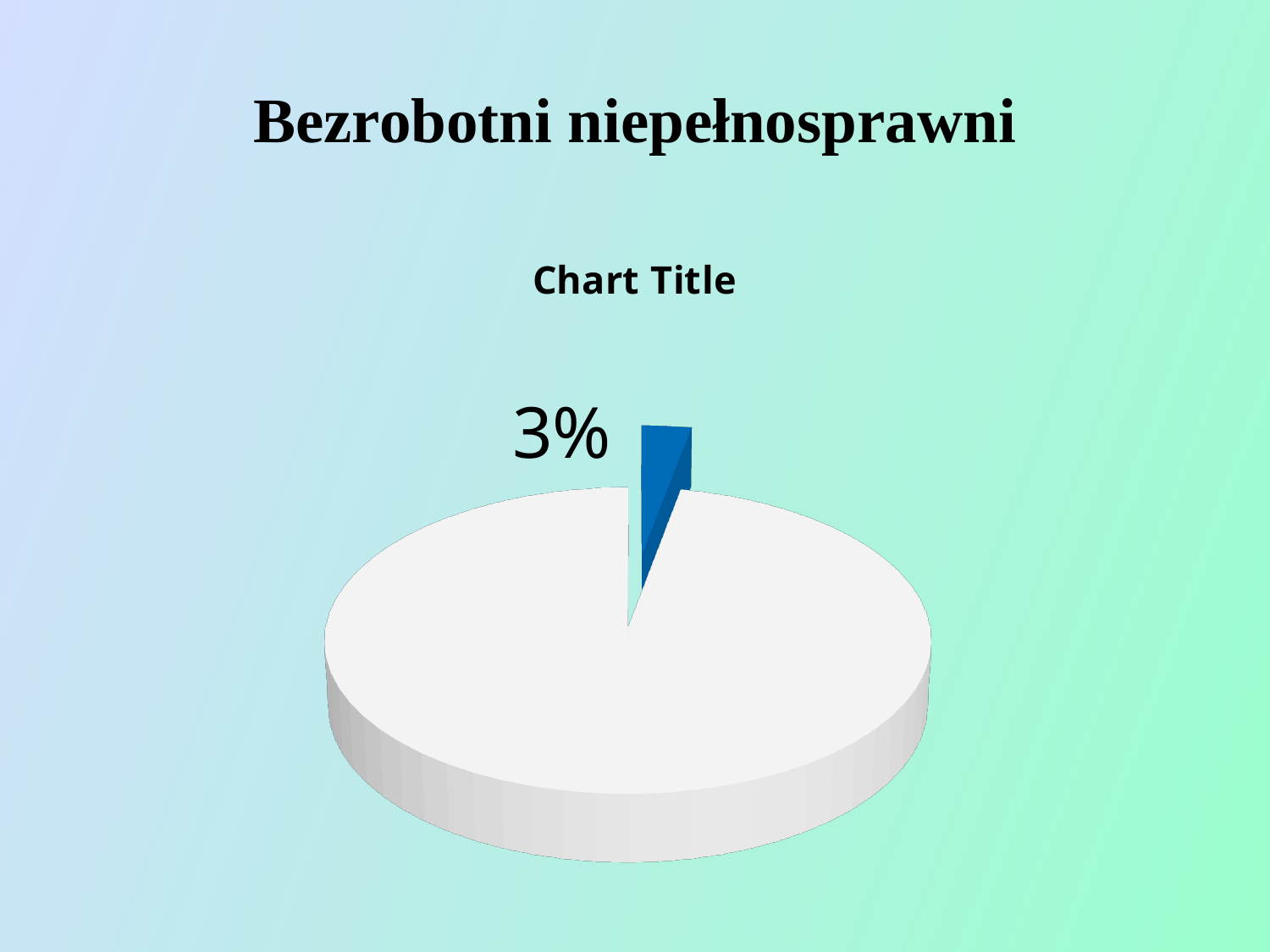
What kind of chart is shown on the slide? pie chart Which slice of the pie chart is the smallest? the blue slice How many slices does the pie chart have? 2 Which slice of the pie chart is larger, the blue slice or the white slice? the white slice What is the title printed above the pie chart? Chart Title What is the title of the slide containing the pie chart? Bezrobotni niepełnosprawni What percentage is shown on the blue slice of the pie chart? 3%